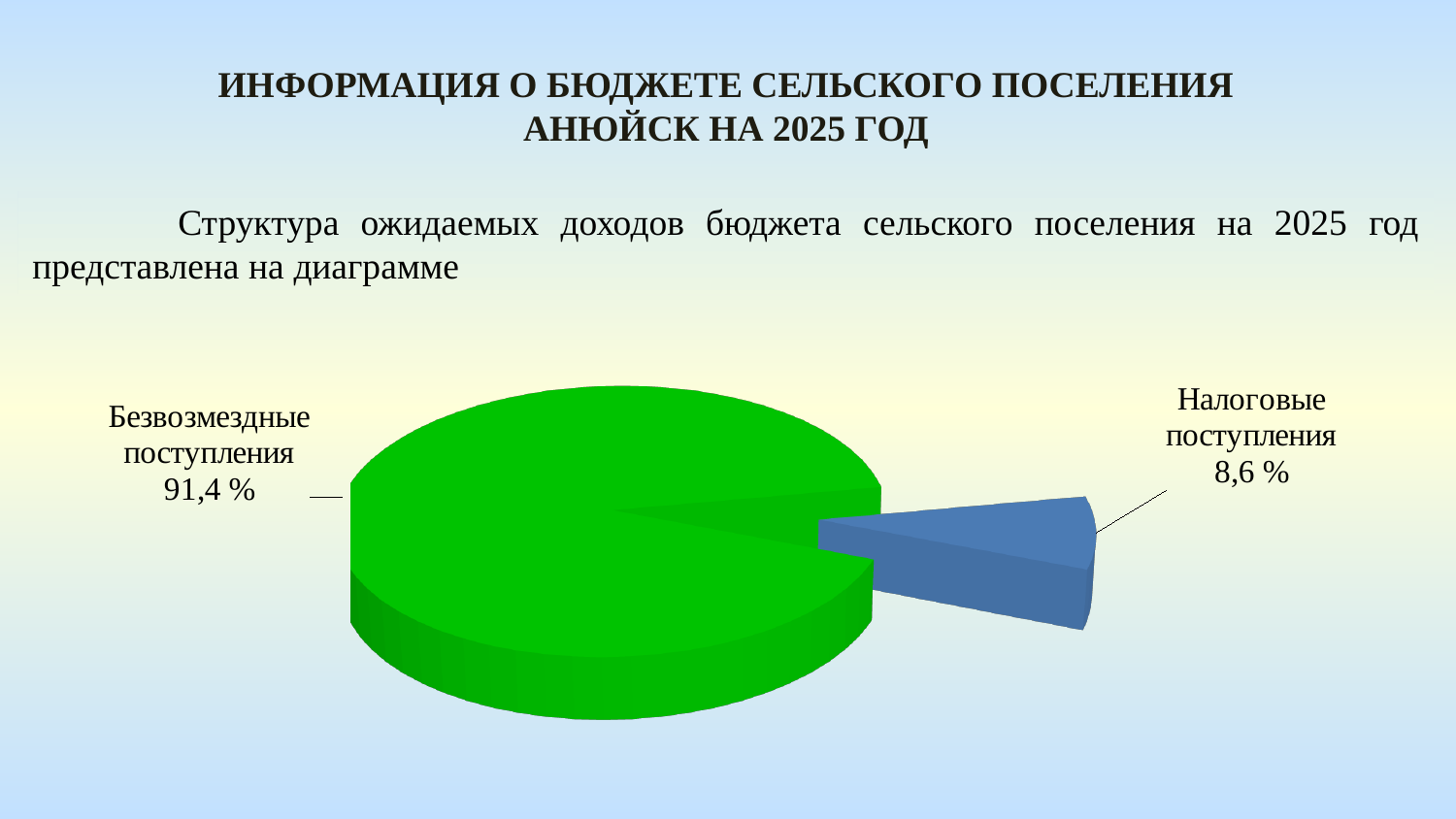
Which category has the smallest slice of the pie? Налоговые поступления How many slices does the pie chart have? 2 Is the share for Налоговые поступления greater or less than 10 %? less What share of the pie does Безвозмездные поступления represent? 91,4 % What share of the pie does Налоговые поступления represent? 8,6 % Which is larger: Безвозмездные поступления or Налоговые поступления? Безвозмездные поступления Which category has the largest slice of the pie? Безвозмездные поступления What colour is the slice for Безвозмездные поступления? Green What is the difference in percentage points between Безвозмездные поступления and Налоговые поступления? 82,8 What kind of chart is shown on the slide? Pie chart Is the share for Безвозмездные поступления greater or less than 90 %? greater What colour is the slice for Налоговые поступления? Blue